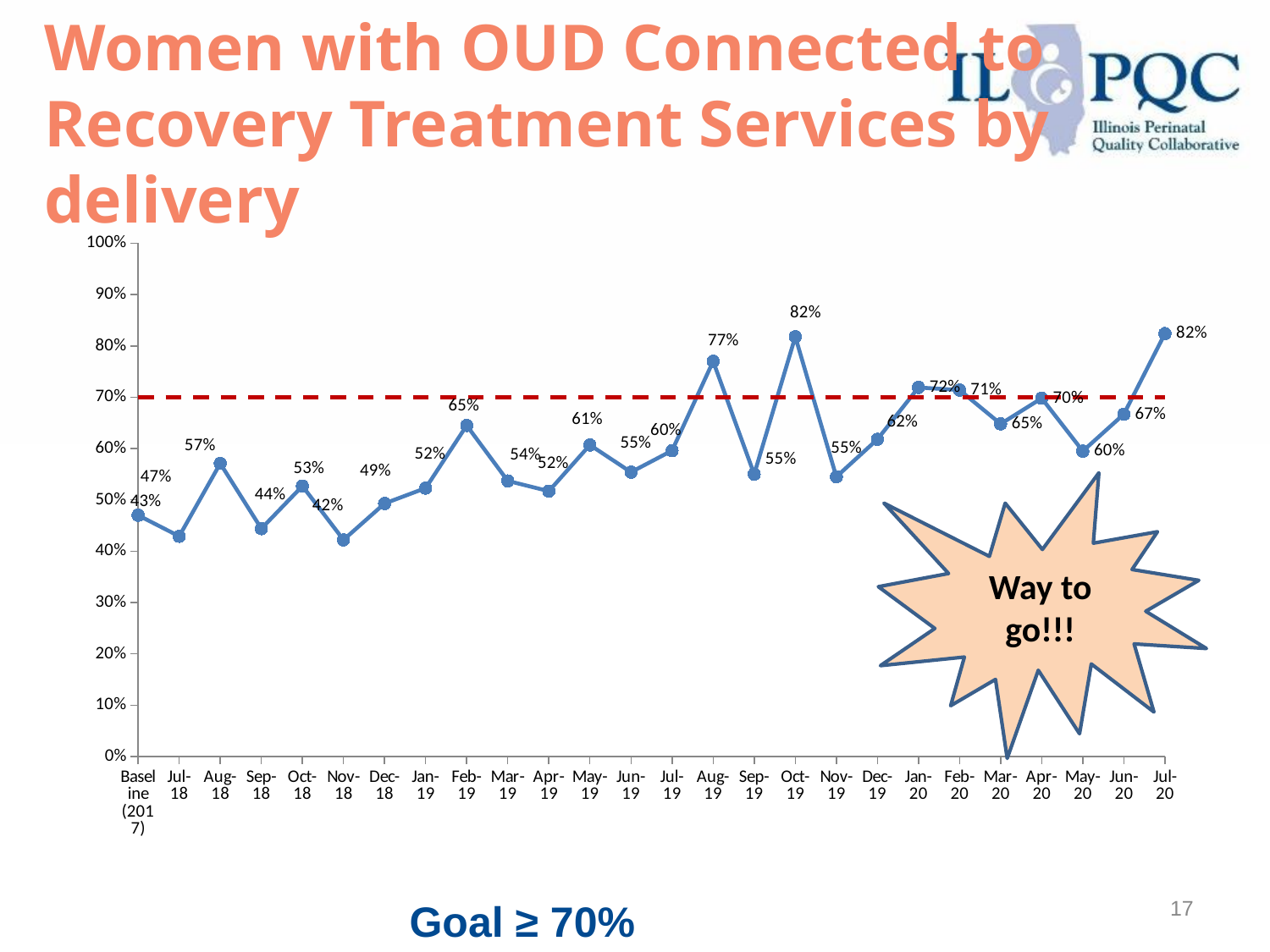
What goal is stated below the chart? Goal ≥ 70% What kind of chart is shown on the slide? line chart What is the value for Aug-19? 77% What is the difference between the values for Jul-20 and Jun-20? 15 percentage points What is the difference between the values for Oct-19 and Sep-19? 27 percentage points Which is larger, the value for Aug-18 or the value for Sep-18? Aug-18 Which month has the lowest value? Nov-18 How many data points are plotted on the chart? 26 What is the value for Jan-20? 72% What is the value for Feb-19? 65% At what value is the horizontal dashed line drawn? 70% What is the value for Mar-20? 65%